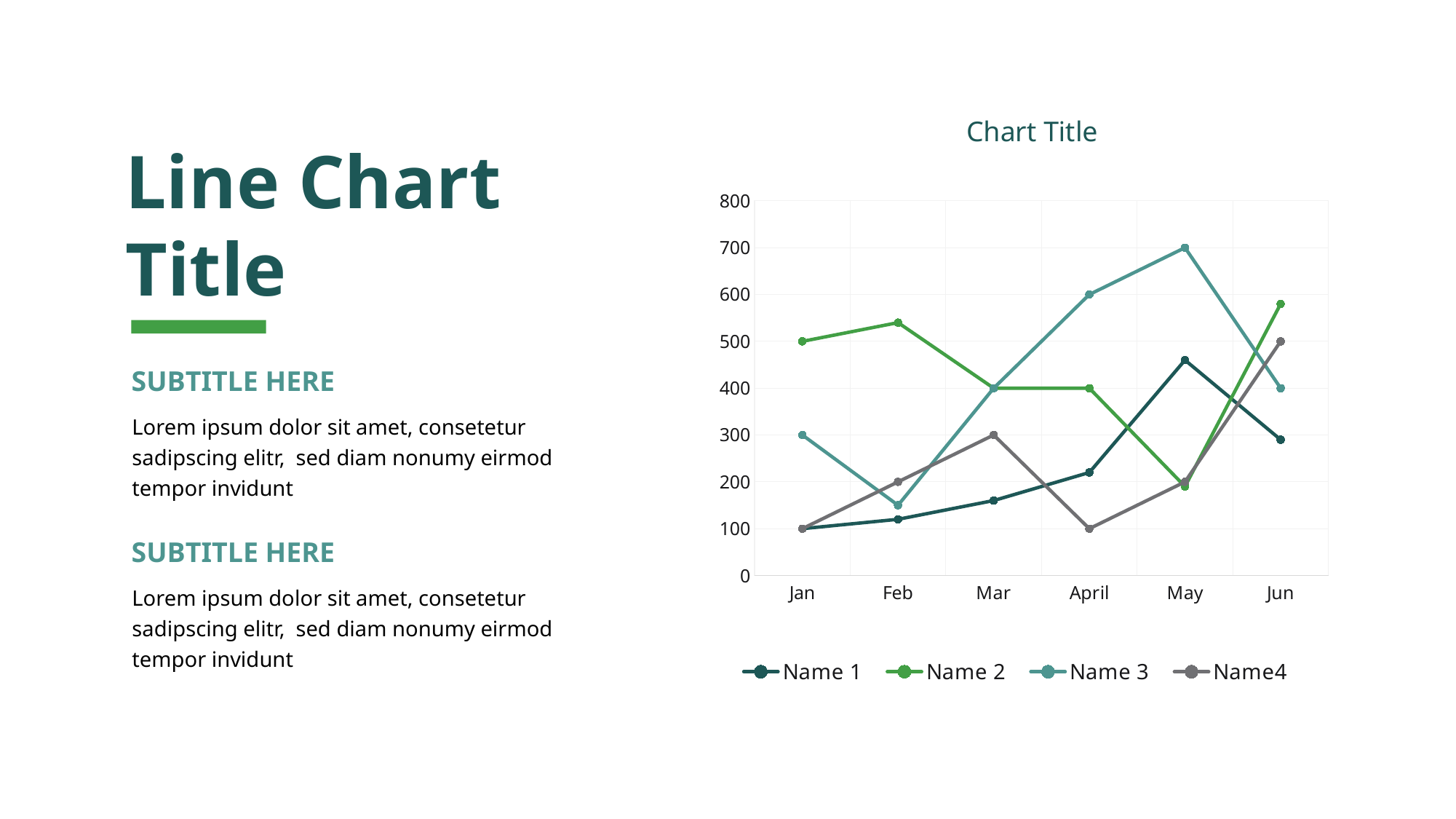
What is the value for Name4 in Jun? 500 Is the value for Name 1 in May greater or less than 400? greater Does Name 1 rise or fall from Jan to May? rise What is the difference between Name 3 in May and Name 3 in Jun? 300 Which is larger in Feb, Name 2 or Name 3? Name 2 What is the value for Name 2 in Jan? 500 What kind of chart is shown on the slide? line chart In which month is Name 2 at its lowest? May What is the value for Name 3 in May? 700 How many series does the legend list? 4 How many months are shown on the x axis? 6 In which month does Name 3 reach its highest value? May